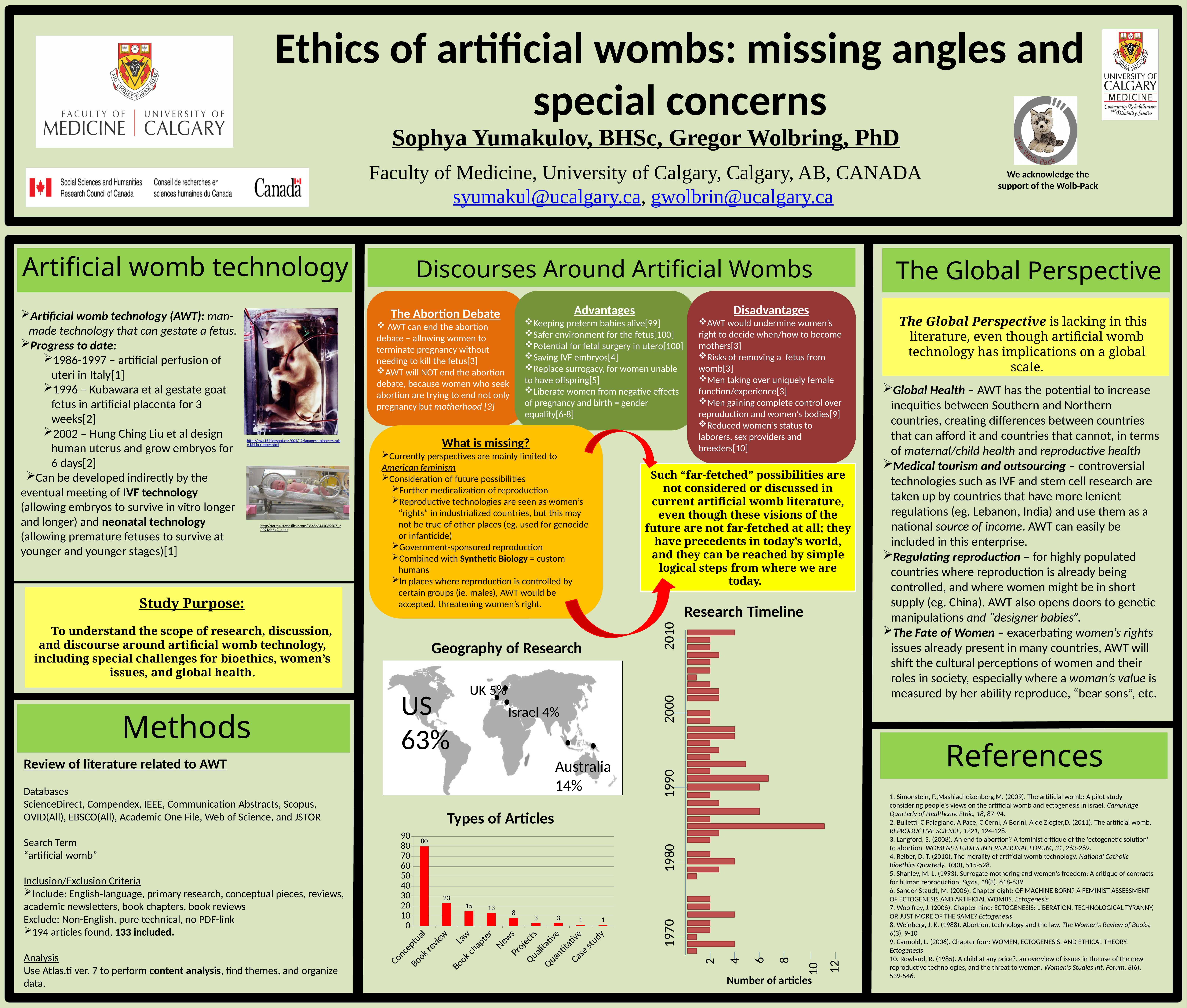
In the Types of Articles chart, which is larger, Book chapter or News? Book chapter In the Types of Articles chart, how many categories are shown on the x axis? 9 In the Types of Articles chart, which category has the highest value? Conceptual What kind of chart is the Types of Articles chart? Bar chart In the Types of Articles chart, how many articles are Conceptual? 80 In the Types of Articles chart, what is the difference between Conceptual and Book review? 57 What kind of chart is the Research Timeline chart? Bar chart In the Types of Articles chart, what is the value for News? 8 In the Research Timeline chart, is the longest bar greater or less than 10 articles? greater In the Types of Articles chart, what is the value for Book review? 23 In the Types of Articles chart, what is the value for Law? 15 In the Types of Articles chart, what is the difference between Law and Book chapter? 2